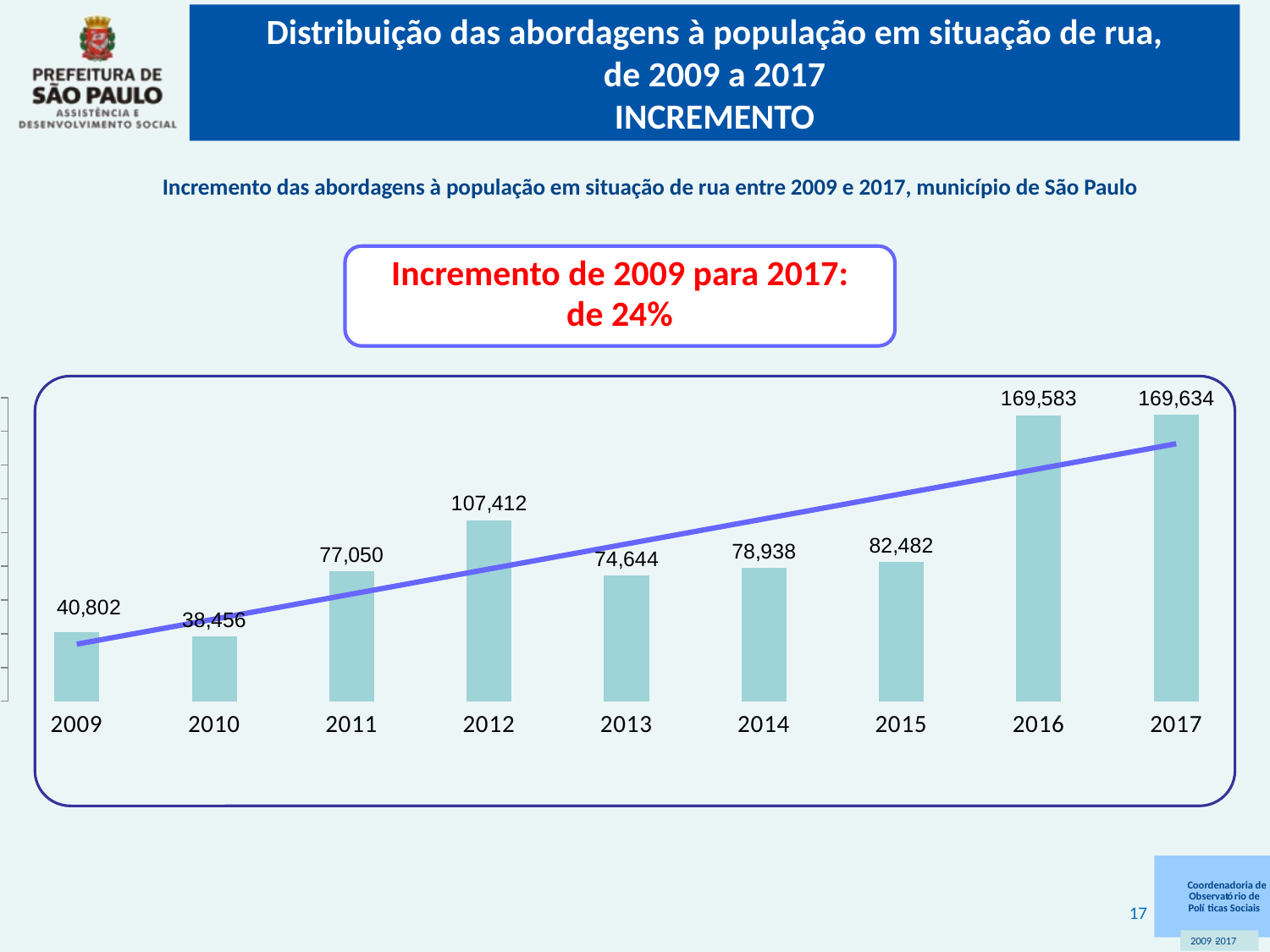
What is the difference between the values for 2017 and 2009? 128,832 What is the value for 2017? 169,634 What is the value for 2016? 169,583 Which is larger, the value for 2013 or the value for 2014? 2014 According to the highlighted box, what is the increment from 2009 to 2017? 24% What kind of chart is this? Bar chart with a trend line What is the value for 2009? 40,802 Which year has the highest value? 2017 Which year has the lowest value? 2010 What is the value for 2012? 107,412 What is the difference between the values for 2012 and 2011? 30,362 How many years are shown on the x axis? 9